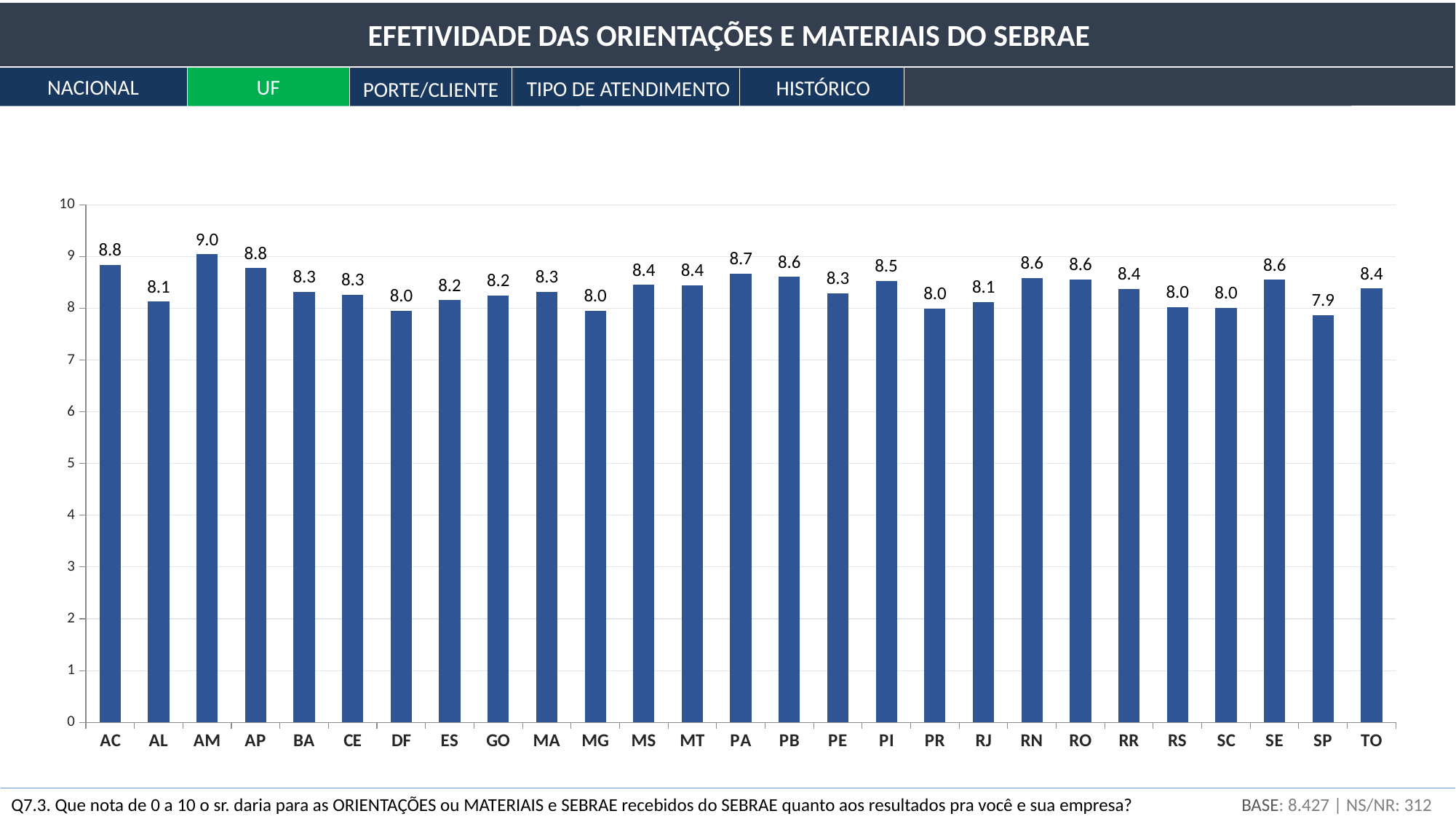
What kind of chart is shown on the slide? Bar chart What is the value for RJ? 8.1 Which has a larger value, PA or PB? PA Is the value for AC greater or less than 8? greater Which state has the lowest value? SP What is the value for PA? 8.7 How many states are shown on the x axis? 27 What is the difference between the values for AC and AL? 0.7 What is the value for SP? 7.9 What is the difference between the values for AM and SP? 1.1 What is the value for AM? 9.0 Which state has the highest value? AM